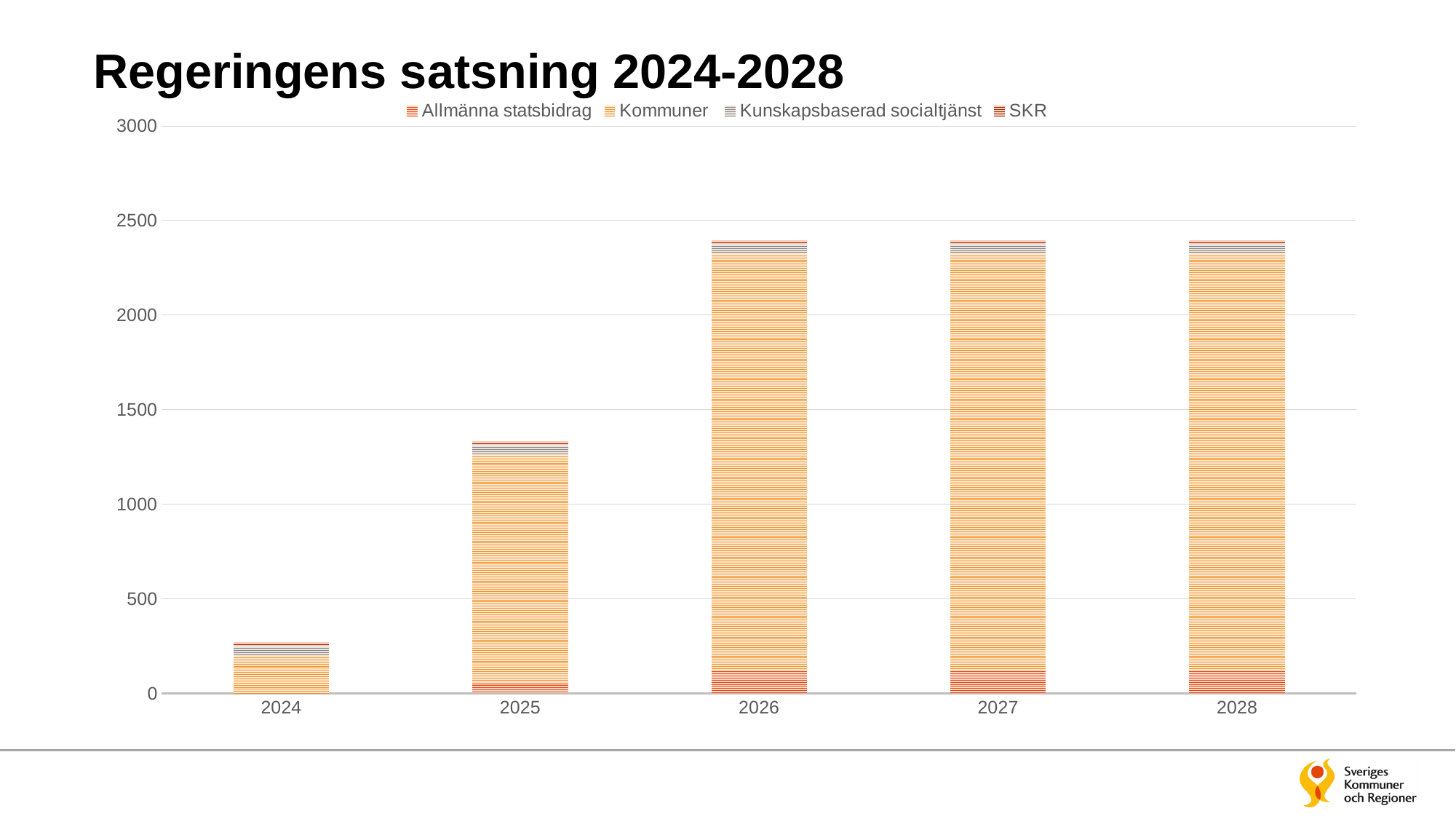
Which year has the lowest total bar? 2024 Is the total bar for 2025 greater or less than 1000? greater How many series does the legend list? 4 Is the total bar for 2024 greater or less than 500? less How many years are shown on the x axis? 5 Do the total bars rise or fall from 2024 to 2026? rise What kind of chart is shown on the slide? bar chart Which is larger, the total bar for 2024 or for 2025? 2025 Is the total bar for 2026 greater or less than 2000? greater What is the title of the chart? Regeringens satsning 2024-2028